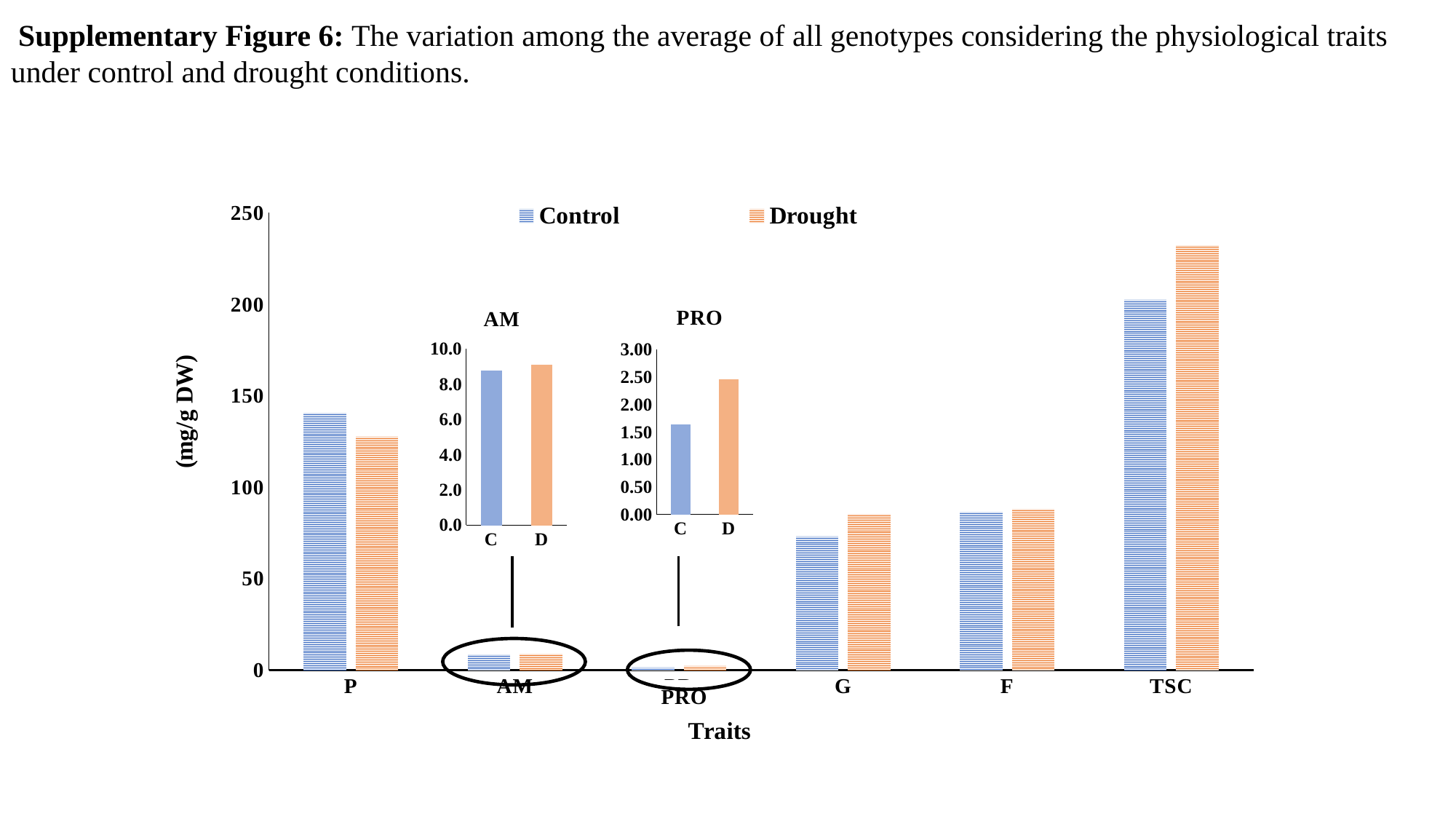
In the main chart, is the Control value for P greater or less than 100? greater In the main chart, is the Drought value for TSC greater or less than 200? greater How many traits are shown on the x axis of the main chart? 6 In the main chart, which is larger for G: the Control value or the Drought value? Drought What is the y-axis label of the main chart? (mg/g DW) How many series does the legend of the main chart list? 2 What kind of chart is the main chart on the slide? bar chart In the AM inset chart, is the value for D greater or less than 8.0? greater In the main chart, which trait has the lowest Drought value? PRO In the main chart, which trait has the highest Control value? TSC In the main chart, which is larger for P: the Control value or the Drought value? Control